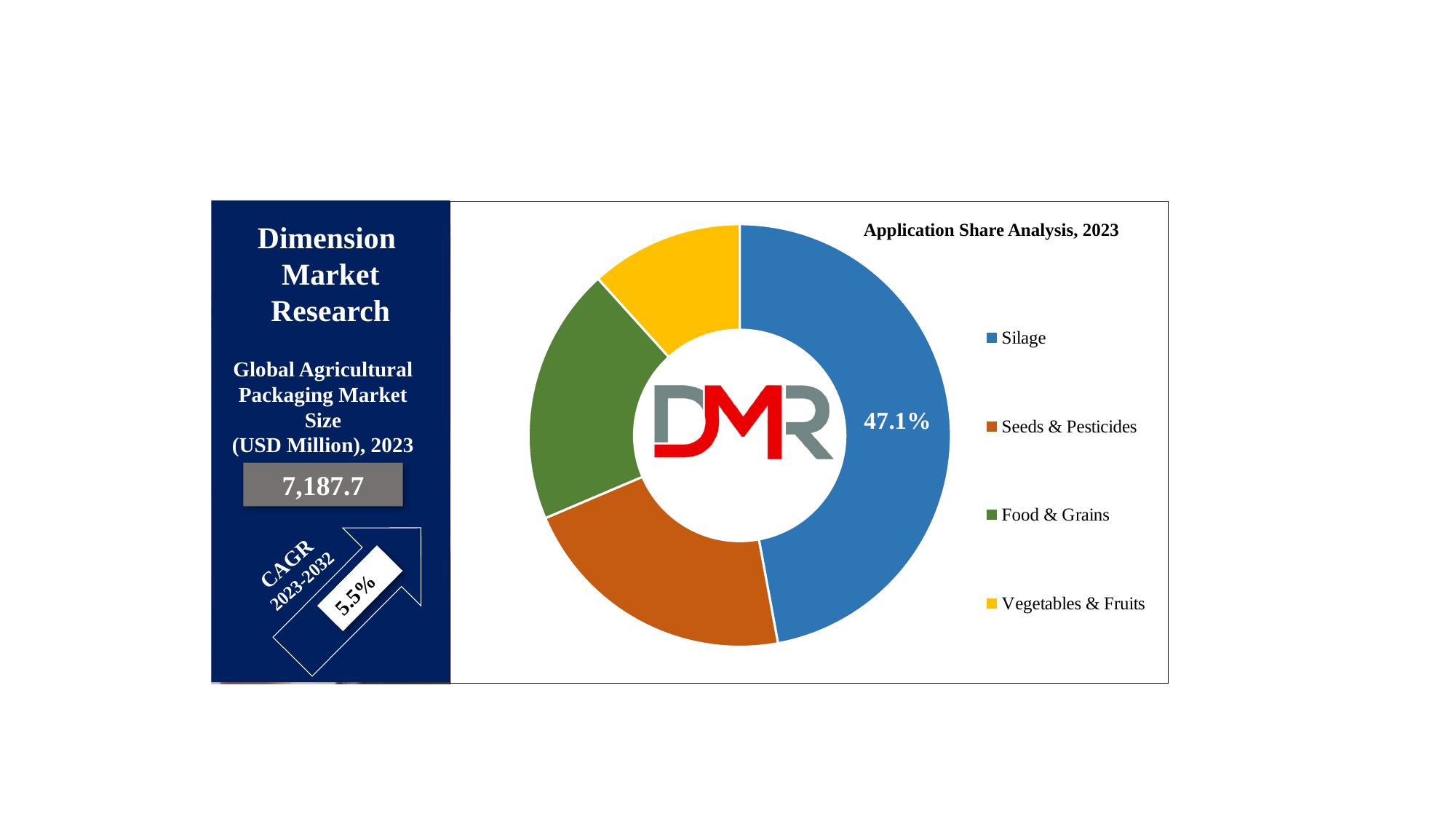
Which has a larger share, Food & Grains or Vegetables & Fruits? Food & Grains Is the share for Seeds & Pesticides greater or less than 47.1%? less Which application has the smallest share in the Application Share Analysis, 2023 chart? Vegetables & Fruits How many application categories are shown in the chart? 4 What share does Silage hold in the Application Share Analysis, 2023 chart? 47.1% Which application has the largest share in the Application Share Analysis, 2023 chart? Silage Which colour represents Vegetables & Fruits in the chart? Yellow Is the share for Silage greater or less than 50%? less What type of chart is used to show the Application Share Analysis, 2023? Pie chart (doughnut) Which has a larger share, Seeds & Pesticides or Food & Grains? Seeds & Pesticides What is the title of the chart? Application Share Analysis, 2023